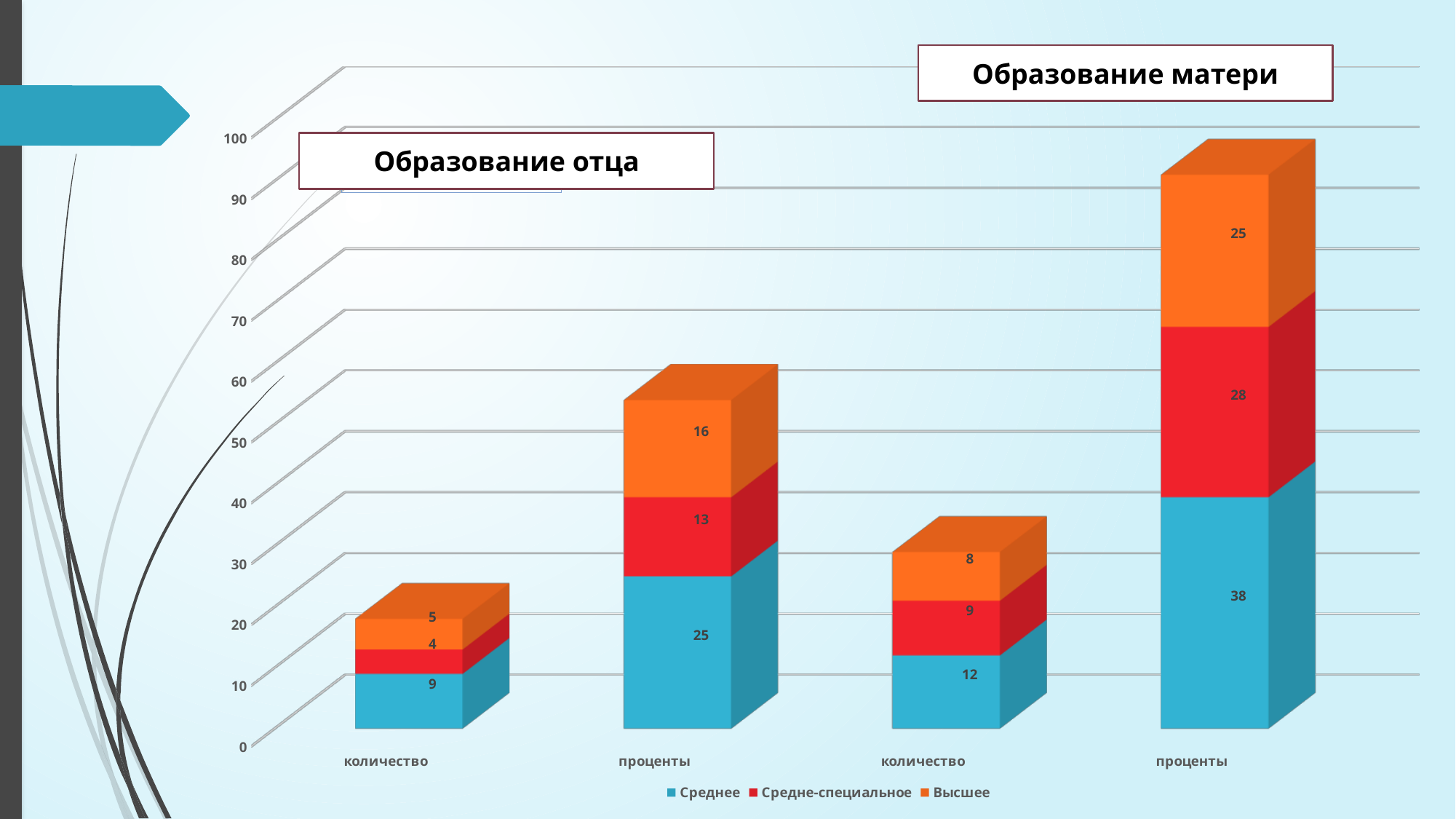
Which bar has the highest total? проценты under Образование матери How many series does the legend list? 3 What is the value of Средне-специальное for the количество bar under Образование матери? 9 How many bars are plotted in the chart? 4 What is the difference between the Среднее values of the проценты bars for Образование матери and Образование отца? 13 Which is larger: the Высшее value for проценты under Образование отца or the Высшее value for количество under Образование матери? проценты under Образование отца What kind of chart is shown on the slide? Stacked bar chart What is the value of Высшее for the проценты bar under Образование матери? 25 What is the total of the stacked количество bar under Образование матери? 29 What is the value of Среднее for the количество bar under Образование отца? 9 Which bar has the lowest total? количество under Образование отца What is the total of the stacked проценты bar under Образование отца? 54